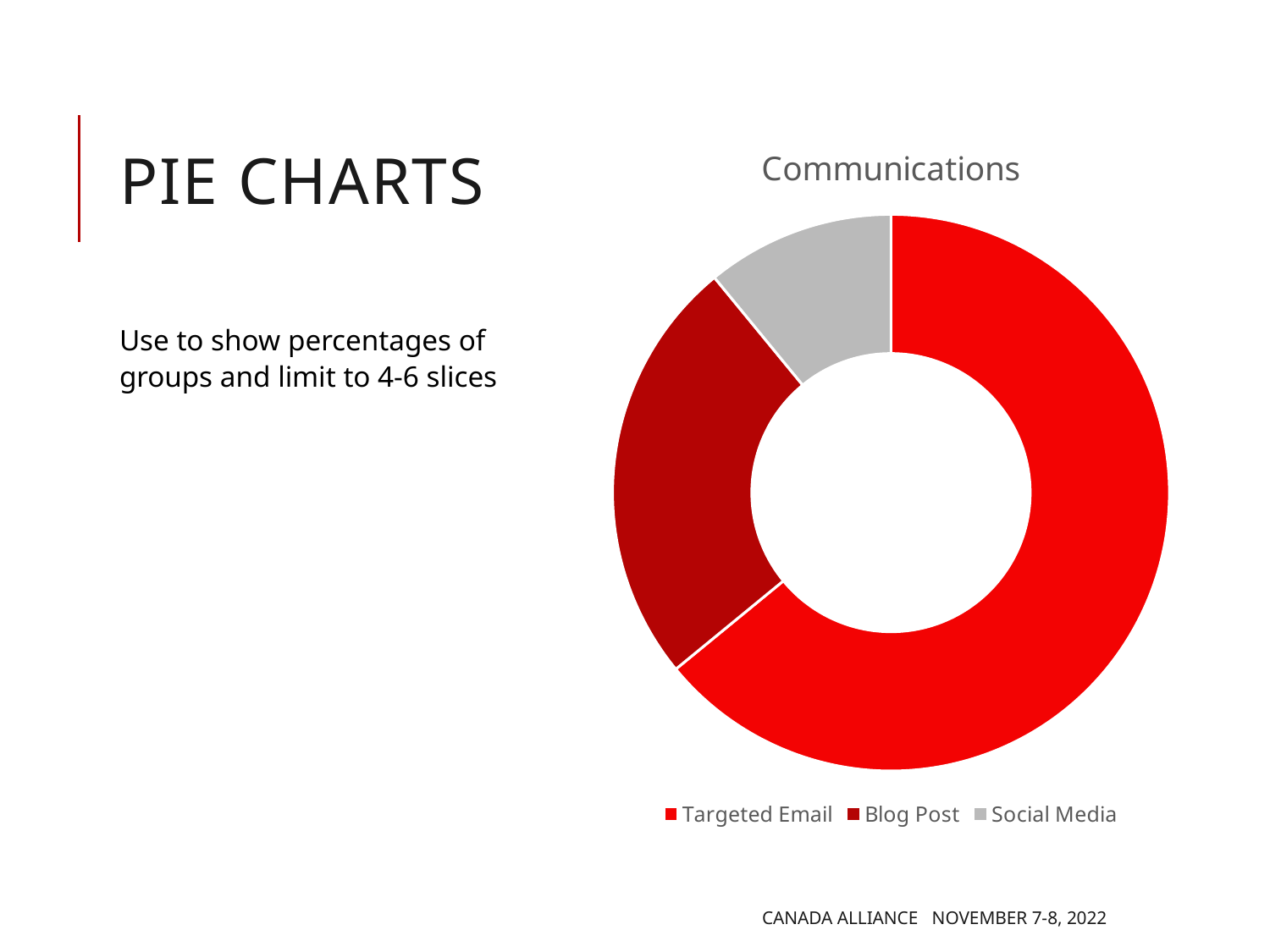
What kind of chart is shown on the slide? doughnut chart Which category has the smallest slice in the Communications chart? Social Media Which category has the largest slice in the Communications chart? Targeted Email What colour is the Social Media slice in the Communications chart? grey What is the title of the chart? Communications How many entries does the legend of the Communications chart list? 3 Which slice is larger in the Communications chart, Targeted Email or Blog Post? Targeted Email How many slices does the Communications chart have? 3 Which slice is larger in the Communications chart, Blog Post or Social Media? Blog Post